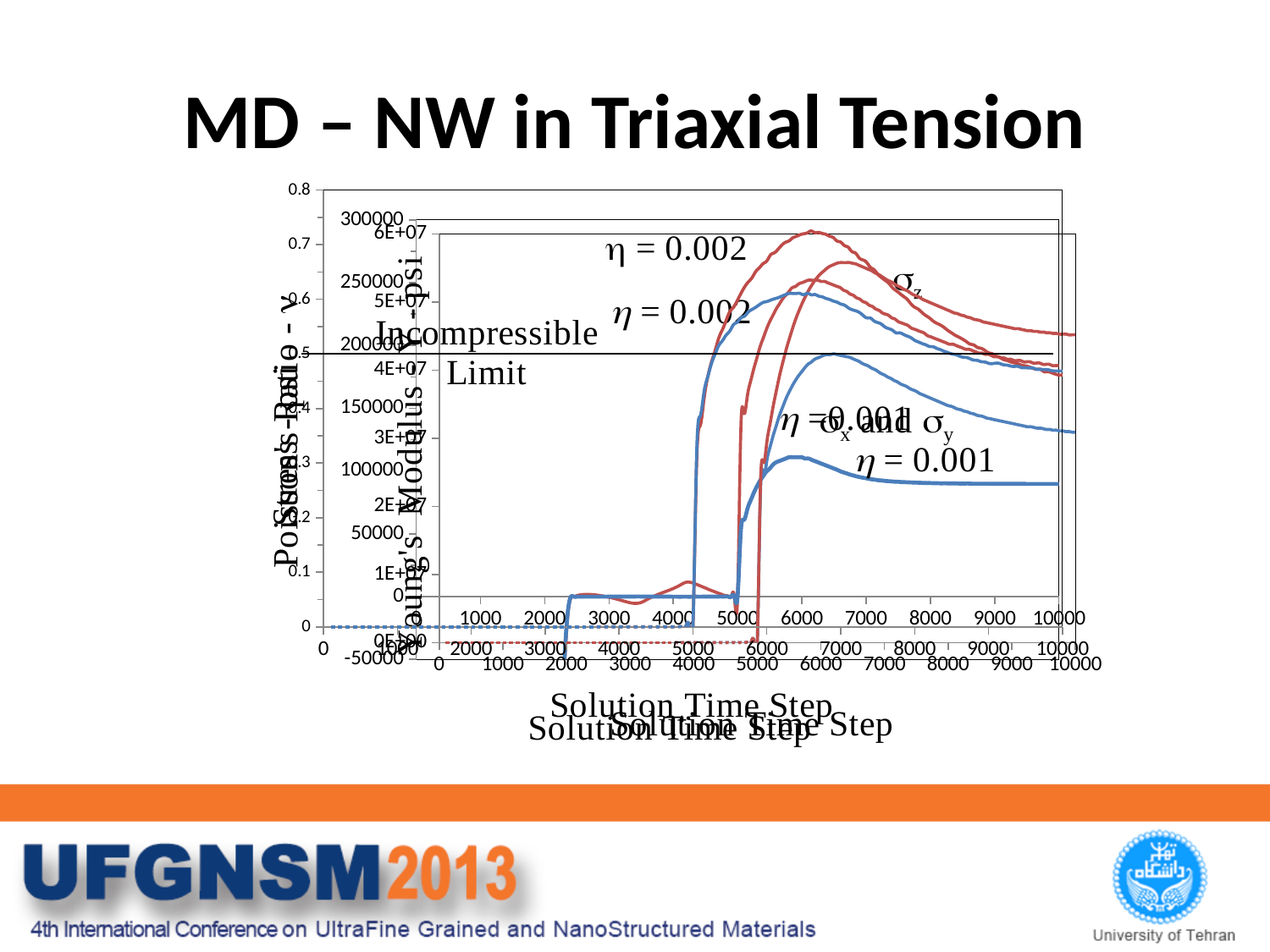
What is the label of the horizontal axis of the charts? Solution Time Step What is the highest tick value shown on the Poisson's Ratio axis (the leftmost vertical axis)? 0.8 What is the title of the slide containing the charts? MD – NW in Triaxial Tension Do the curves rise or fall between time step 5000 and time step 6000? rise What is the highest tick value shown on the Young's Modulus axis? 6E+07 At what Poisson's Ratio value is the horizontal line labelled 'Incompressible Limit' drawn? 0.5 What kind of chart is shown on the slide? line chart What is the lowest tick value shown on the Stress axis? -50000 What is the highest tick value shown on the horizontal axis? 10000 What is the highest tick value shown on the Stress axis? 300000 Which two values of η are labelled on the curves? 0.002 and 0.001